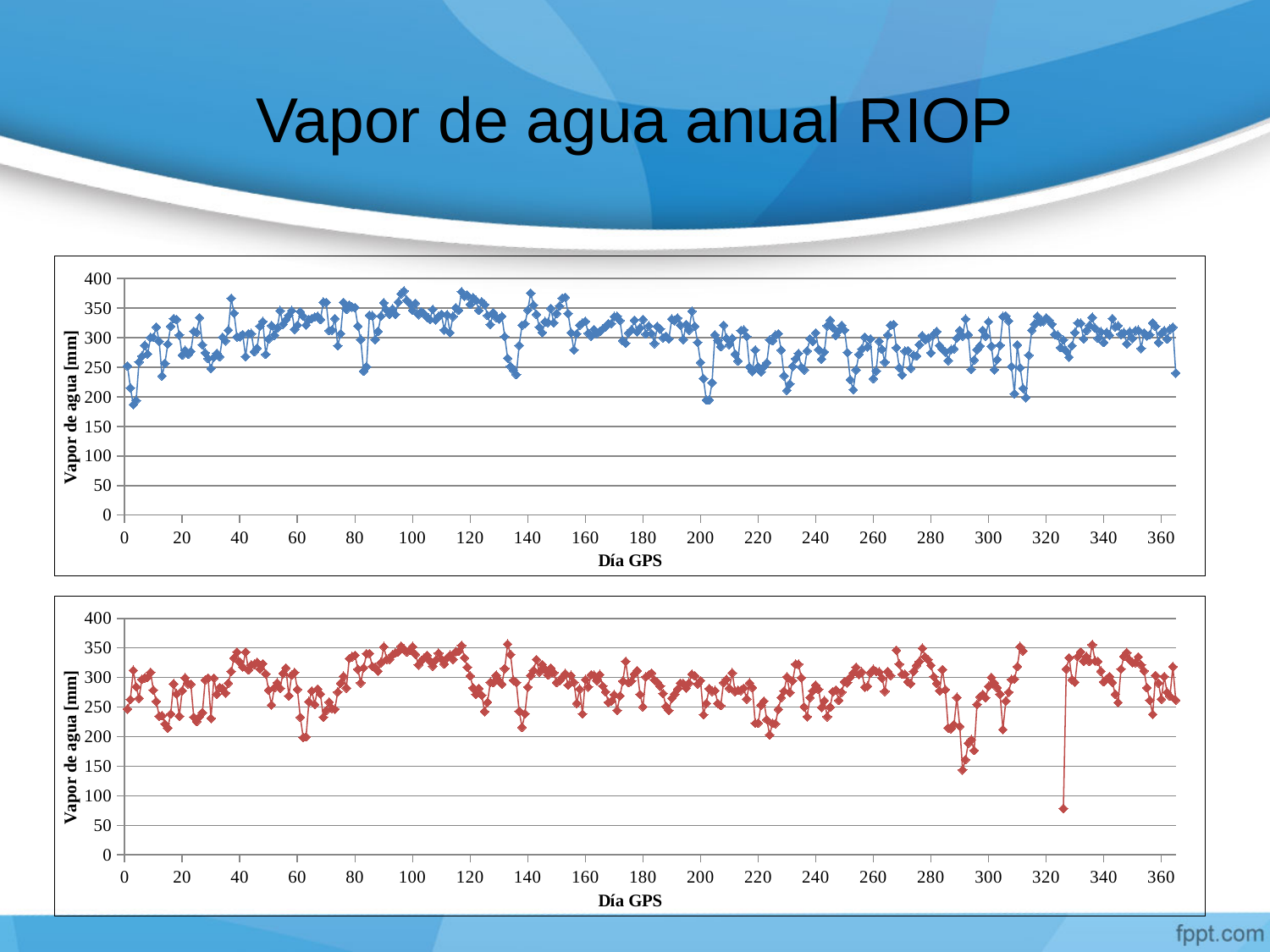
In the bottom chart, is the lowest plotted value (near day 326) greater or less than 100? less What is the x-axis label of the bottom chart? Día GPS In the bottom chart, is the value at day 0 greater or less than 300? less What kind of chart is the bottom chart on the slide? line chart In the top chart, is the highest plotted value (near day 97) greater or less than 350? greater What kind of chart is the top chart on the slide? line chart What is the y-axis label of the top chart? Vapor de agua [mm] What is the maximum value shown on the y-axis of the bottom chart? 400 How many charts are shown on the slide? 2